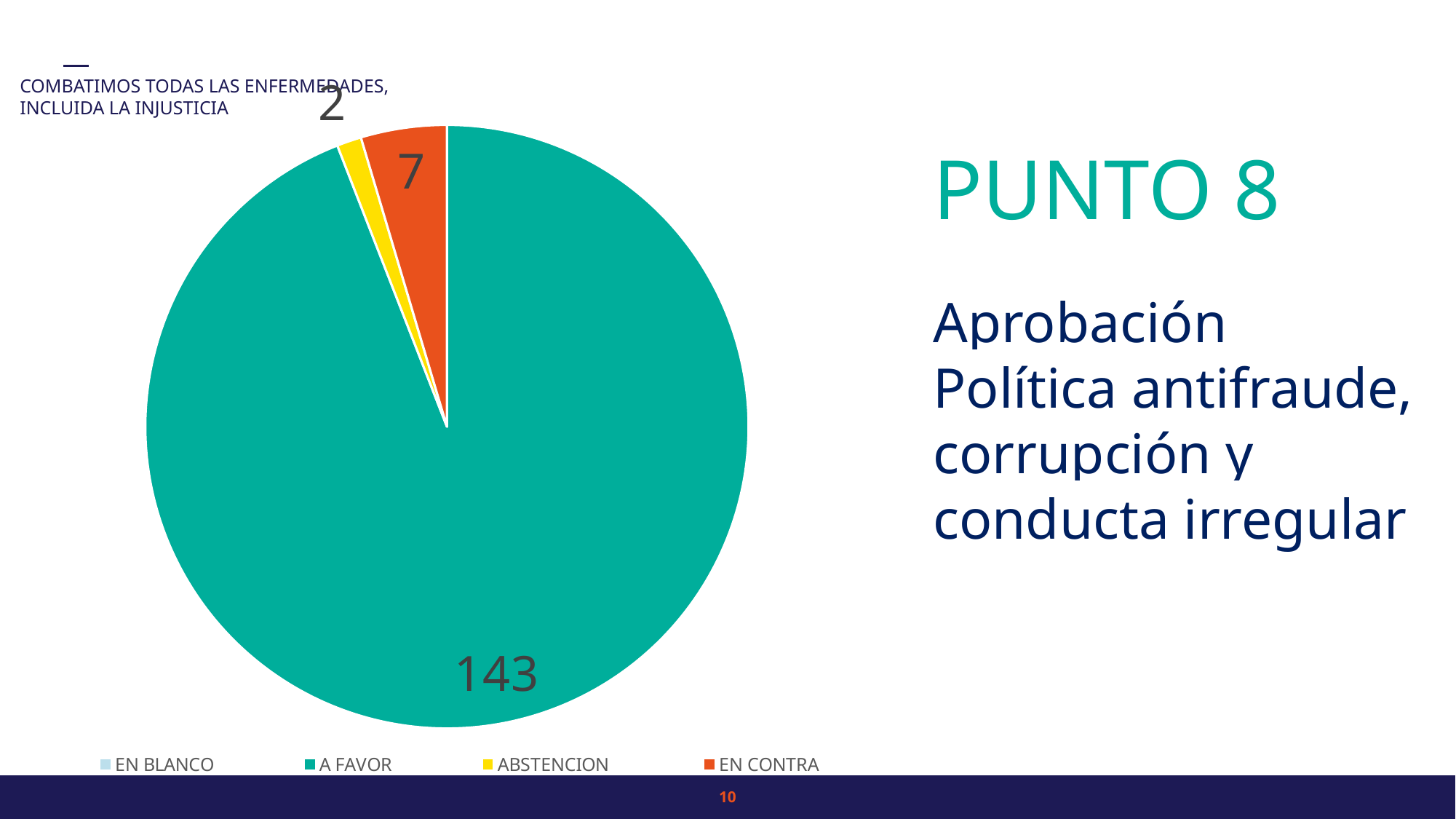
What is the difference between the A FAVOR value and the EN CONTRA value? 136 What colour is the A FAVOR slice in the pie chart? teal How many categories does the legend of the pie chart list? 4 Which is larger, the value for EN CONTRA or the value for ABSTENCION? EN CONTRA What is the difference between the EN CONTRA value and the ABSTENCION value? 5 What type of chart is shown on the slide? pie chart What is the value for ABSTENCION in the pie chart? 2 What is the value for EN CONTRA in the pie chart? 7 What is the value for A FAVOR in the pie chart? 143 Which legend entry is shown in yellow? ABSTENCION Which labelled category has the smallest slice in the pie chart? ABSTENCION Which category has the largest slice in the pie chart? A FAVOR